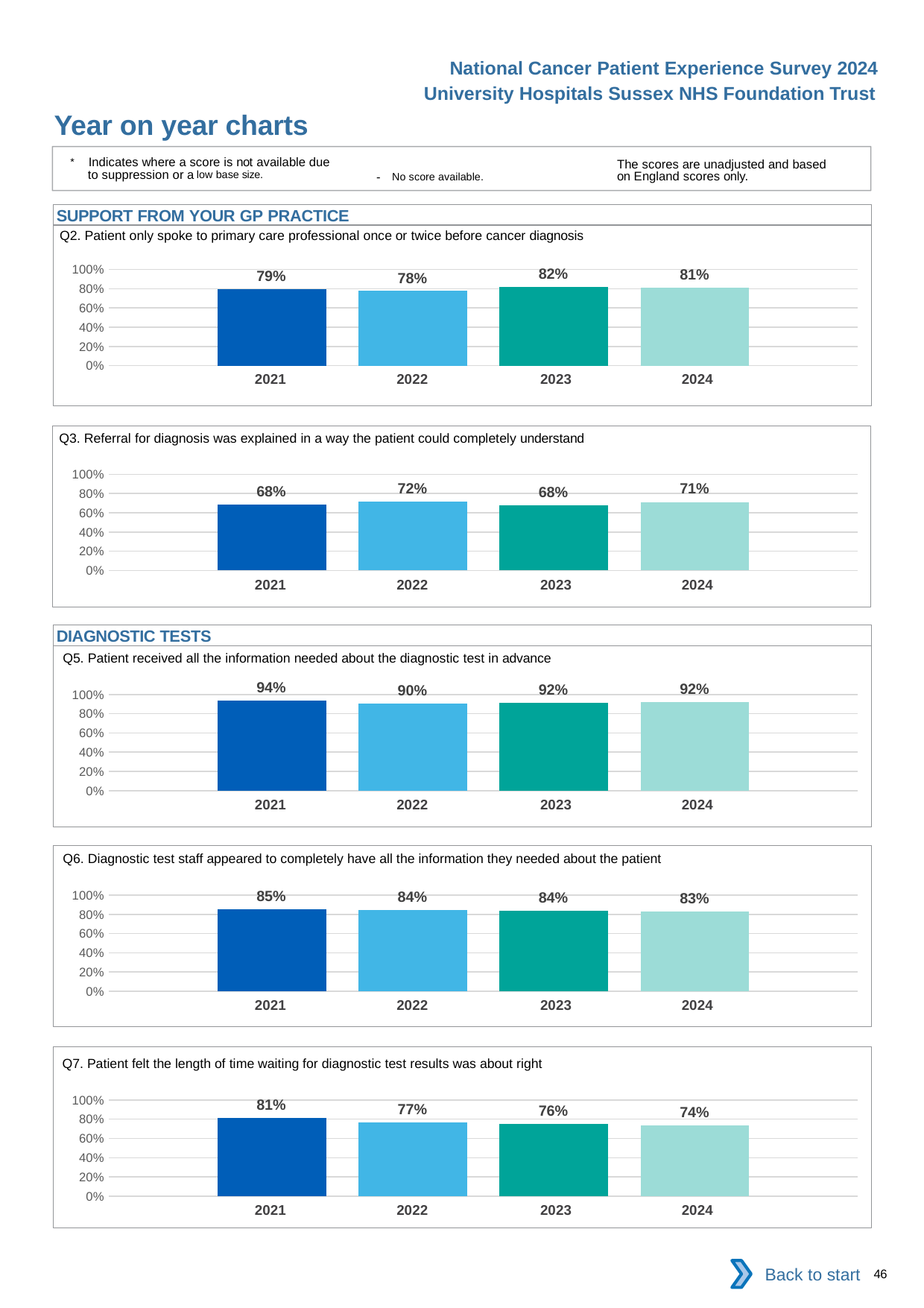
How many years are shown in the Q7 chart? 4 In the Q7 chart, what is the difference between the 2021 and 2024 values? 7 percentage points In the Q2 chart, which year has the lowest value? 2022 What type of chart is the Q2 chart? bar chart In the Q2 chart, what is the value for 2023? 82% In the Q6 chart, what is the value for 2024? 83% In the Q5 chart, which year has the highest value? 2021 In the Q7 chart, do the values rise or fall from 2021 to 2024? fall In the Q6 chart, is the value for 2021 larger or smaller than the value for 2024? larger In the Q3 chart, what is the difference between the 2022 and 2021 values? 4 percentage points In the Q3 chart, what is the value for 2024? 71% In the Q5 chart, what is the value for 2022? 90%